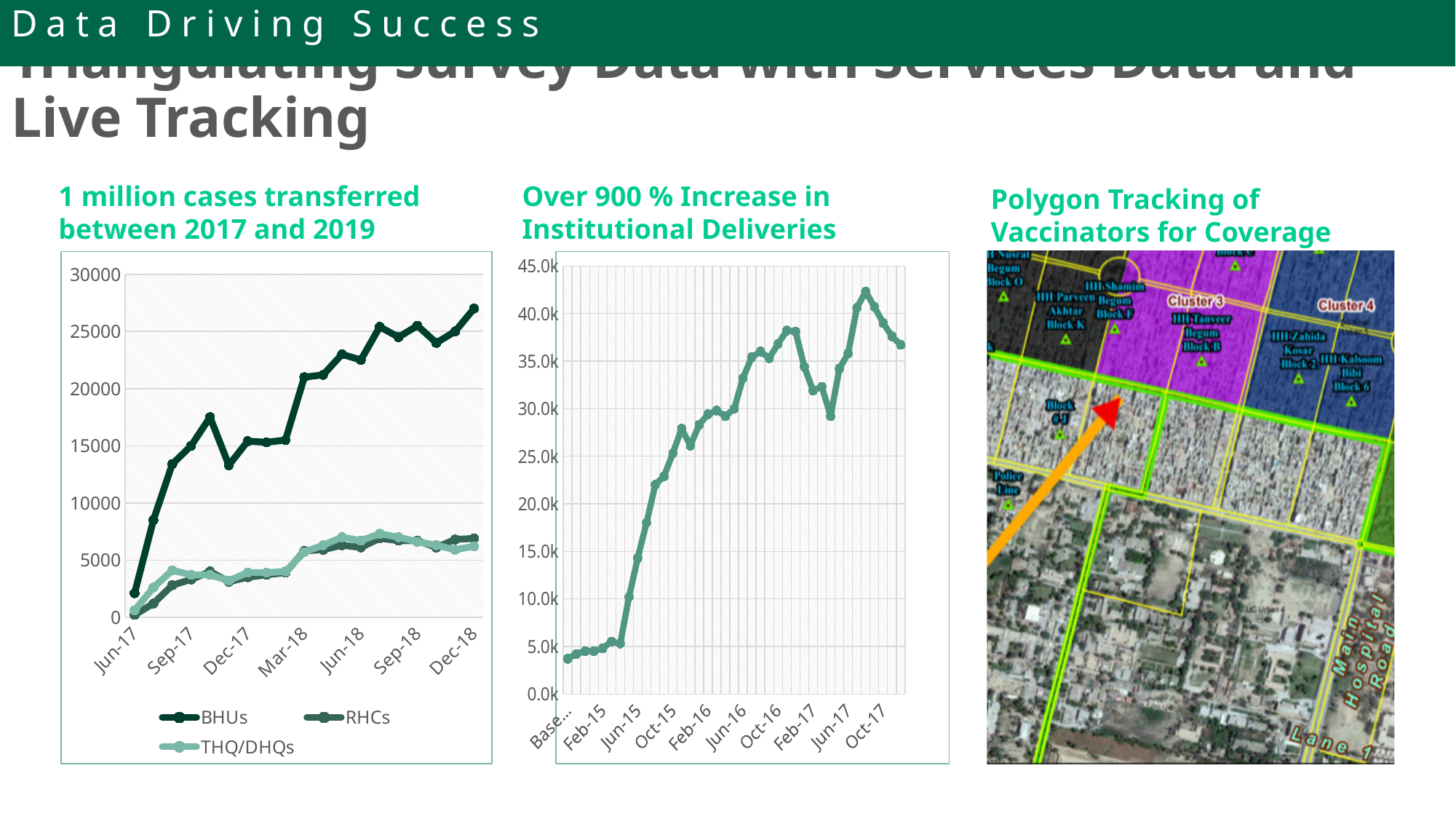
What kind of chart is the chart titled 'Over 900 % Increase in Institutional Deliveries'? line chart In the chart titled 'Over 900 % Increase in Institutional Deliveries', is the value at Feb-15 greater or less than 10.0k? less In the chart titled '1 million cases transferred between 2017 and 2019', is the BHUs value at Dec-18 greater or less than 25000? greater In the chart titled 'Over 900 % Increase in Institutional Deliveries', do the values rise or fall from the baseline to Oct-15? rise What are the legend entries in the chart titled '1 million cases transferred between 2017 and 2019'? BHUs, RHCs, THQ/DHQs In the chart titled '1 million cases transferred between 2017 and 2019', which series is larger at Dec-18, BHUs or RHCs? BHUs In the chart titled '1 million cases transferred between 2017 and 2019', is the BHUs value at Jun-17 greater or less than 5000? less In the chart titled '1 million cases transferred between 2017 and 2019', do the BHUs values generally rise or fall from Jun-17 to Dec-18? rise What kind of chart is the chart titled '1 million cases transferred between 2017 and 2019'? line chart How many series does the legend list in the chart titled '1 million cases transferred between 2017 and 2019'? 3 In the chart titled '1 million cases transferred between 2017 and 2019', which series has the highest values across the period? BHUs